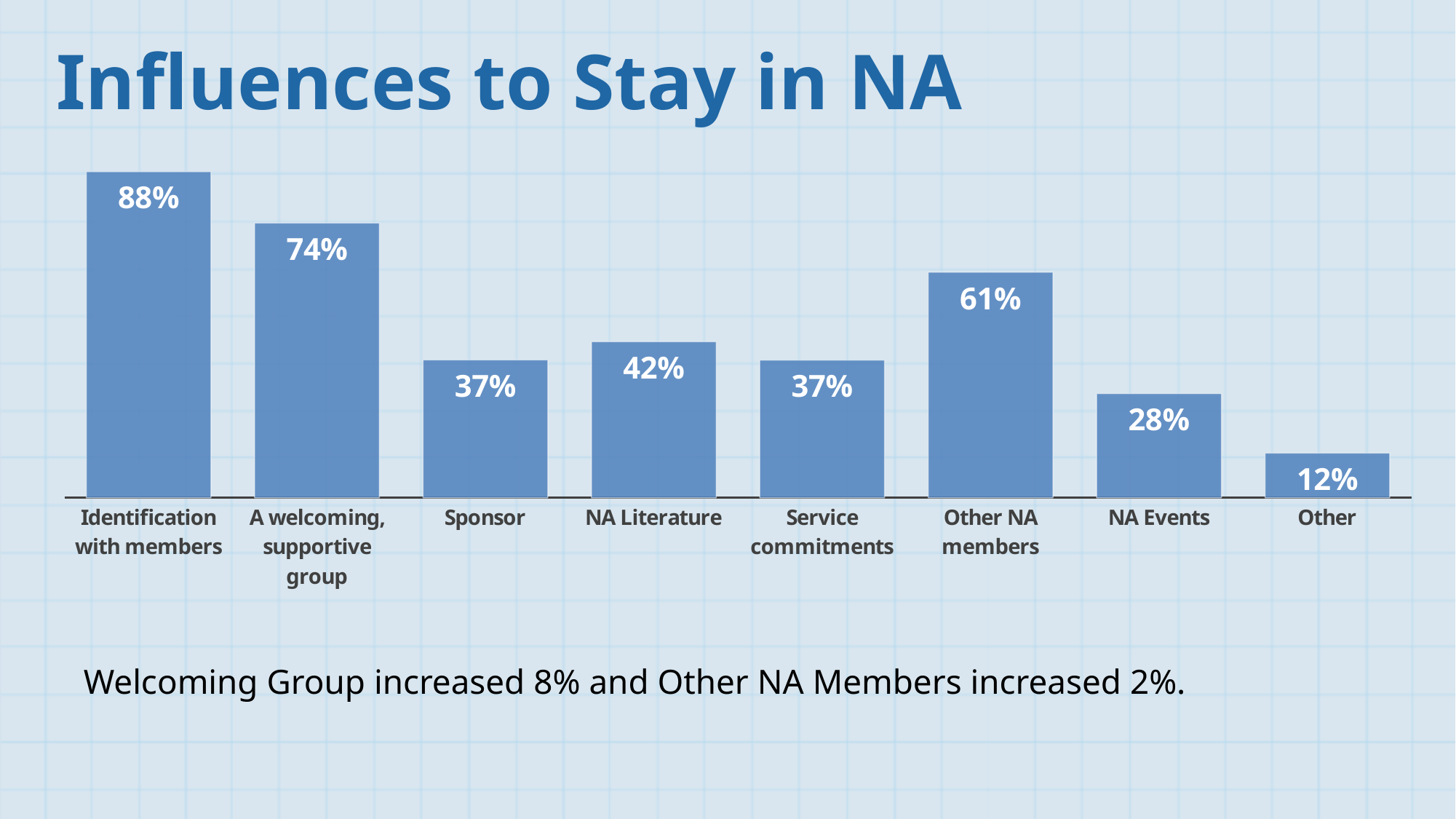
Which is larger, the value for NA Literature or the value for Sponsor? NA Literature What is the value for A welcoming, supportive group? 74% How many categories are shown in the chart? 8 What is the value for Other NA members? 61% What kind of chart is shown on the slide? Bar chart Which category has the lowest value? Other What is the value for Identification with members? 88% What is the difference between the values for Identification with members and A welcoming, supportive group? 14% What is the value for NA Literature? 42% What is the value for NA Events? 28% What is the title of the slide? Influences to Stay in NA Which category has the highest value? Identification with members